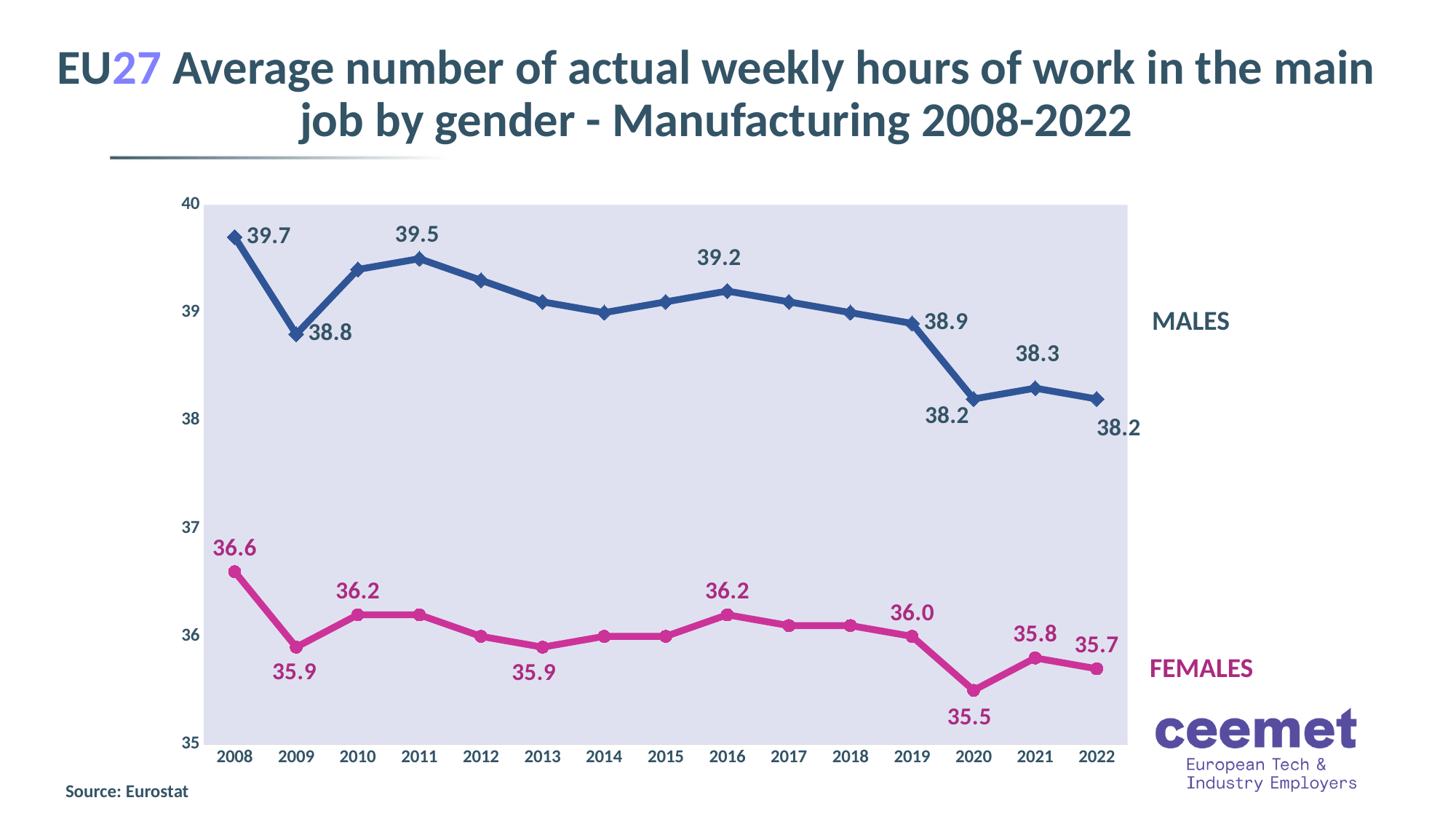
What is the value for MALES in 2008? 39.7 In which year is the FEMALES value lowest? 2020 Is the value for MALES in 2010 greater or less than 39? greater In which year is the MALES value highest? 2008 What is the difference between the MALES and FEMALES values in 2022? 2.5 What is the value for FEMALES in 2022? 35.7 What is the difference between the MALES value in 2008 and in 2022? 1.5 What kind of chart is shown on the slide? line chart Which year has the larger MALES value, 2019 or 2021? 2019 What is the value for FEMALES in 2020? 35.5 How many years are shown on the x axis? 15 What is the value for MALES in 2011? 39.5